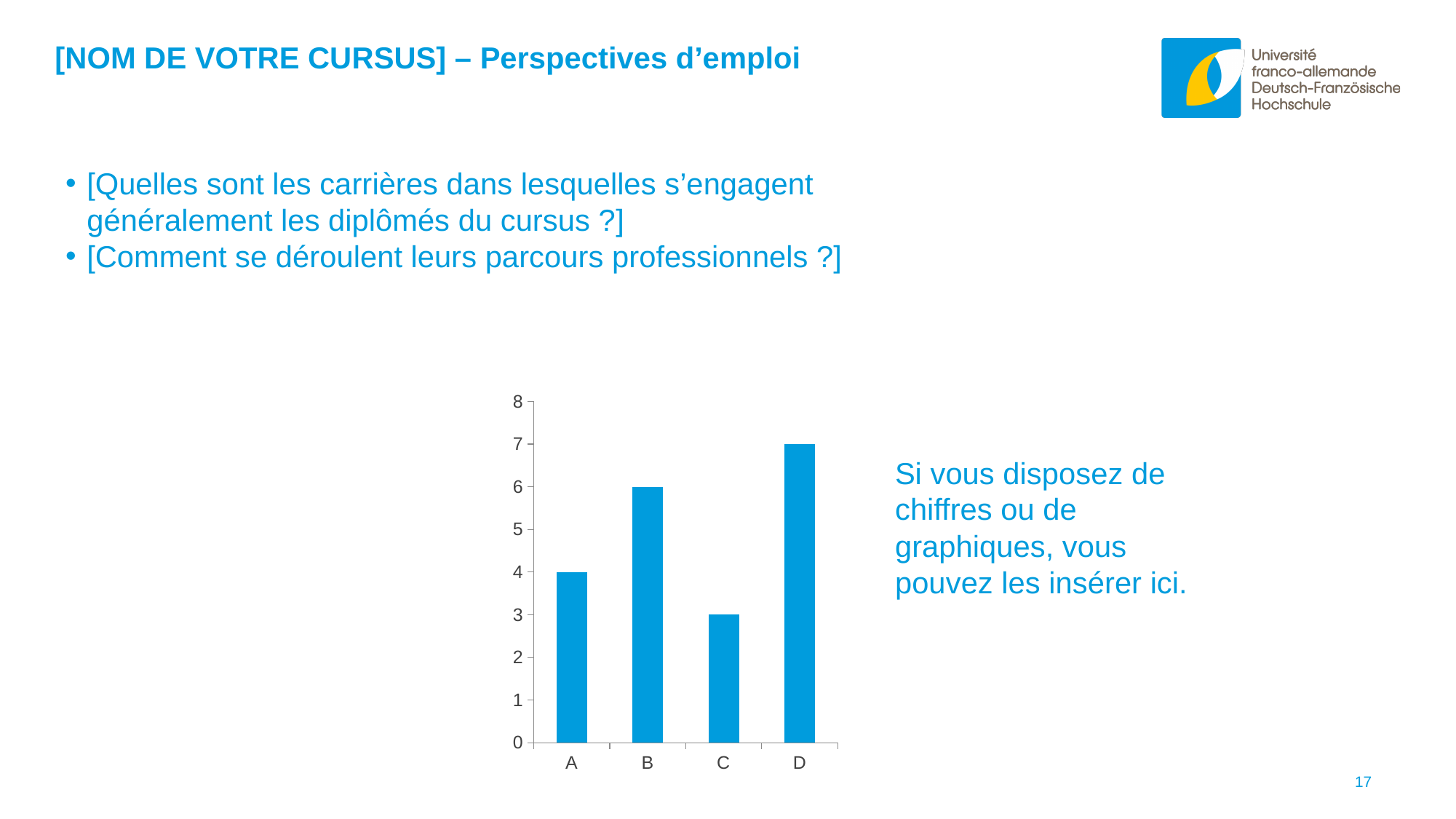
What kind of chart is shown on the slide? bar chart How many categories are shown on the x axis? 4 What is the value for category B? 6 What is the difference between the values for D and C? 4 What is the value for category C? 3 Which is larger, the value for A or the value for B? B Which category has the highest value? D What is the value for category A? 4 Is the value for D greater or less than 5? greater What is the value for category D? 7 Which category has the lowest value? C What is the difference between the values for B and A? 2